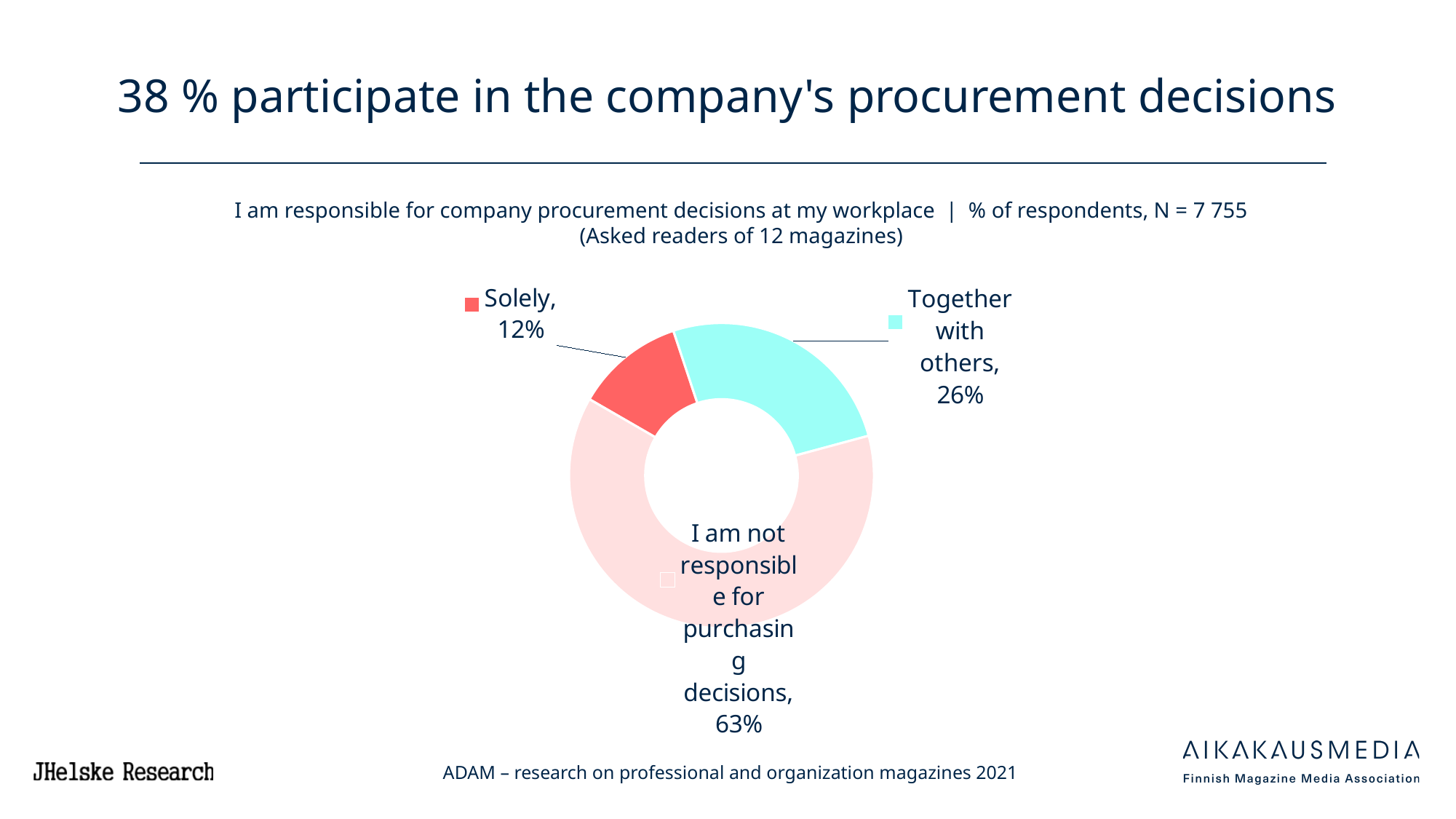
What is the difference in percentage points between 'I am not responsible for purchasing decisions' and 'Together with others'? 37 Which is larger: the share for 'Solely' or the share for 'Together with others'? Together with others Which category has the largest share of respondents? I am not responsible for purchasing decisions What is the difference in percentage points between 'Together with others' and 'Solely'? 14 Which category has the smallest share of respondents? Solely How many categories does the chart show? 3 What percentage of respondents are solely responsible for company procurement decisions? 12% What percentage of respondents are not responsible for purchasing decisions? 63% What percentage of respondents are responsible for procurement decisions together with others? 26% What colour is the 'Solely' slice? Red What is the number of respondents (N) stated in the chart subtitle? 7 755 What kind of chart is shown on the slide? Doughnut (pie) chart